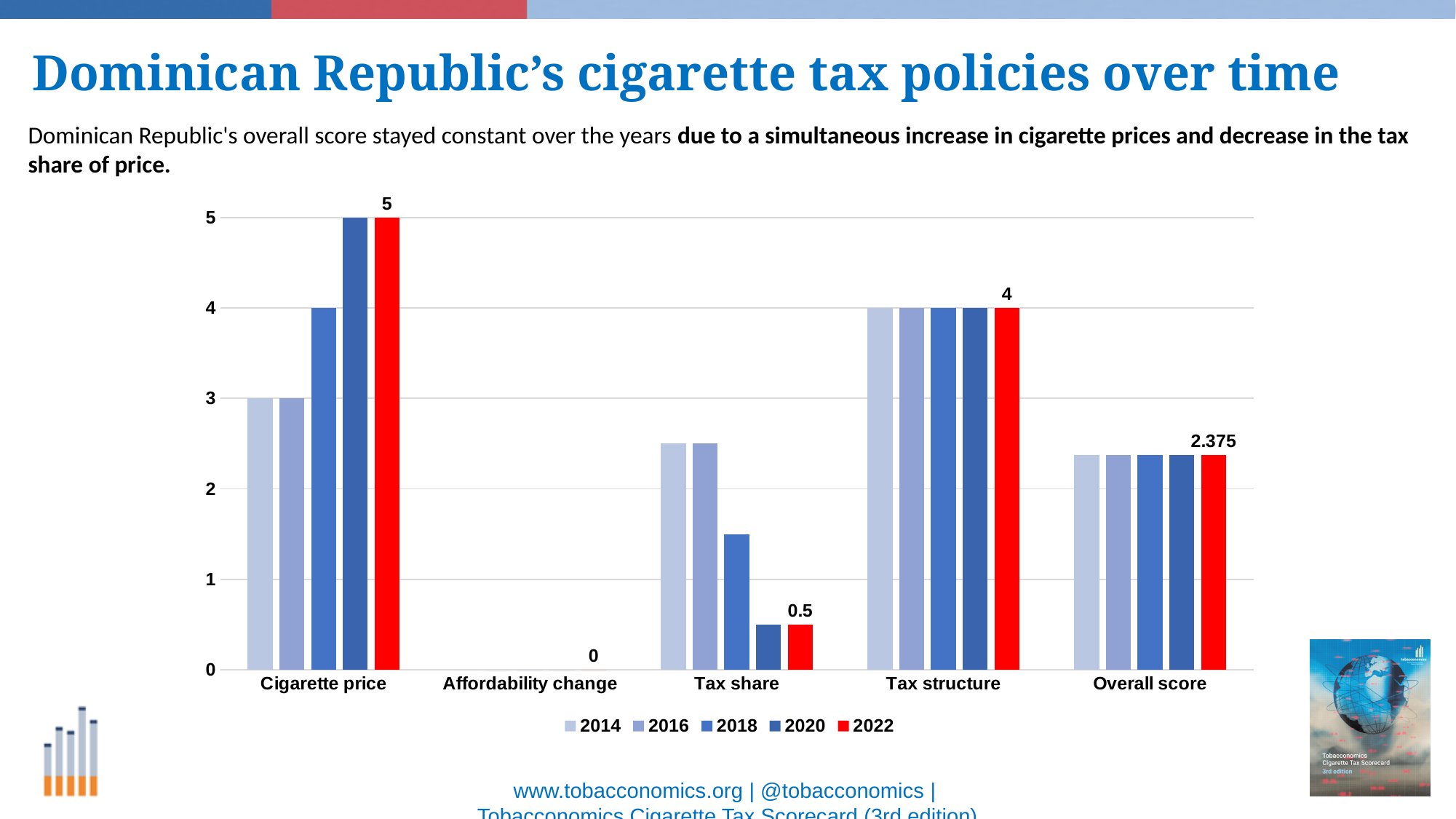
Is the value for Tax share in 2014 greater or less than 2? greater What is the value for Affordability change in 2022? 0 What is the value for Overall score in 2022? 2.375 How many categories are shown on the x axis? 5 How many series does the legend list? 5 What is the value for Cigarette price in 2014? 3 What is the value for Cigarette price in 2022? 5 Do the Tax share values rise or fall from 2014 to 2022? fall What is the value for Tax share in 2022? 0.5 What kind of chart is shown on the slide? bar chart Do the Cigarette price values rise or fall from 2014 to 2022? rise What is the difference between the 2022 values for Cigarette price and Tax share? 4.5